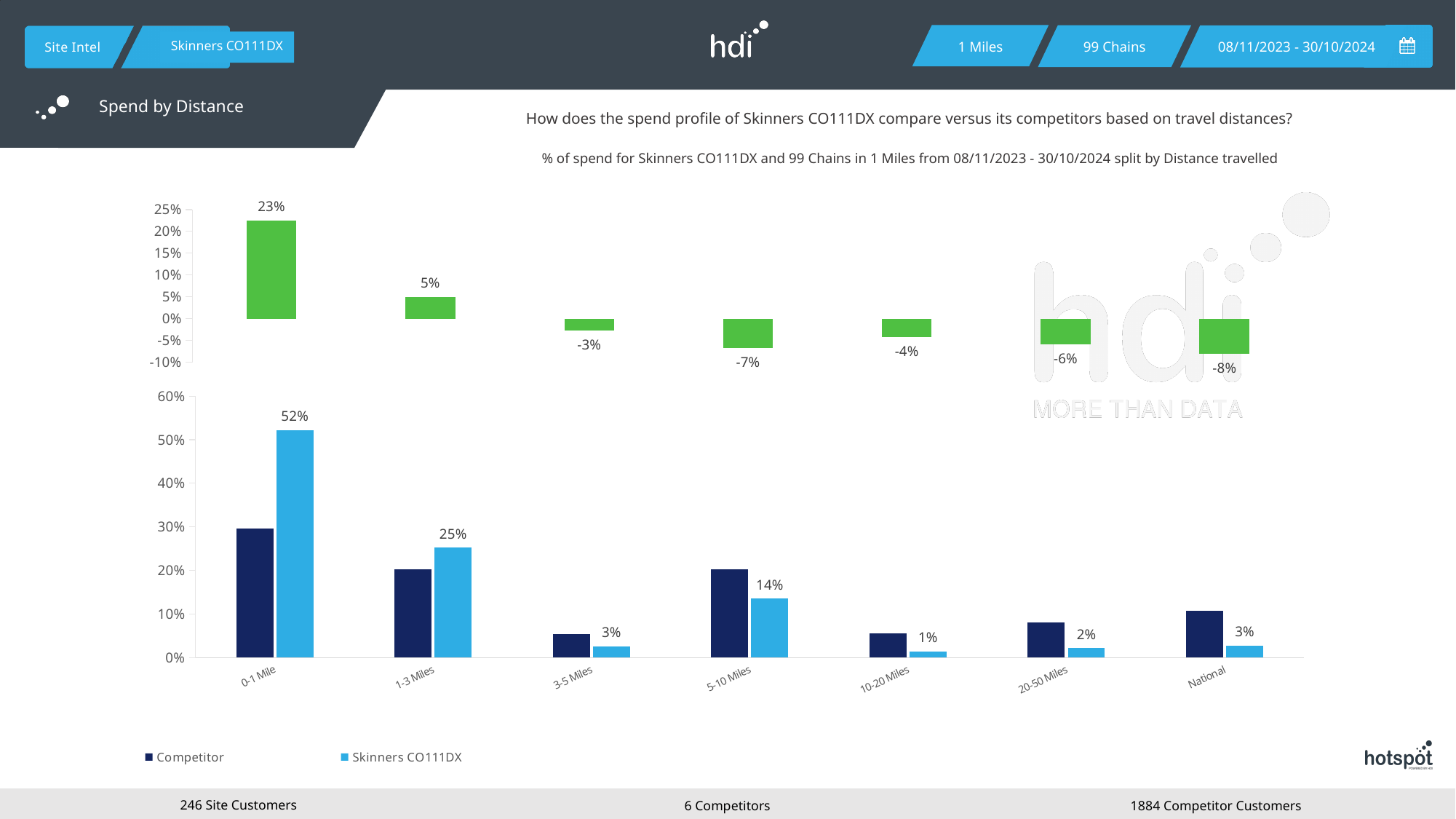
In the bottom chart, what is the value for Skinners CO111DX at 0-1 Mile? 52% In the bottom chart, what is the difference between the Skinners CO111DX values for 0-1 Mile and 1-3 Miles? 27% How many distance categories are shown on the x axis of the bottom chart? 7 In the bottom chart, at 5-10 Miles, which series has the larger value: Competitor or Skinners CO111DX? Competitor In the top chart, which distance band has the lowest value? National In the top chart, which distance band has the highest value? 0-1 Mile In the top chart, what is the value shown for 5-10 Miles? -7% In the bottom chart, what is the value for Skinners CO111DX at 5-10 Miles? 14% How many series does the legend of the bottom chart list? 2 In the bottom chart, is the Competitor value for 0-1 Mile greater or less than 20%? greater In the bottom chart, at 0-1 Mile, which series has the larger value: Competitor or Skinners CO111DX? Skinners CO111DX In the bottom chart, is the Competitor value for National greater or less than 20%? less